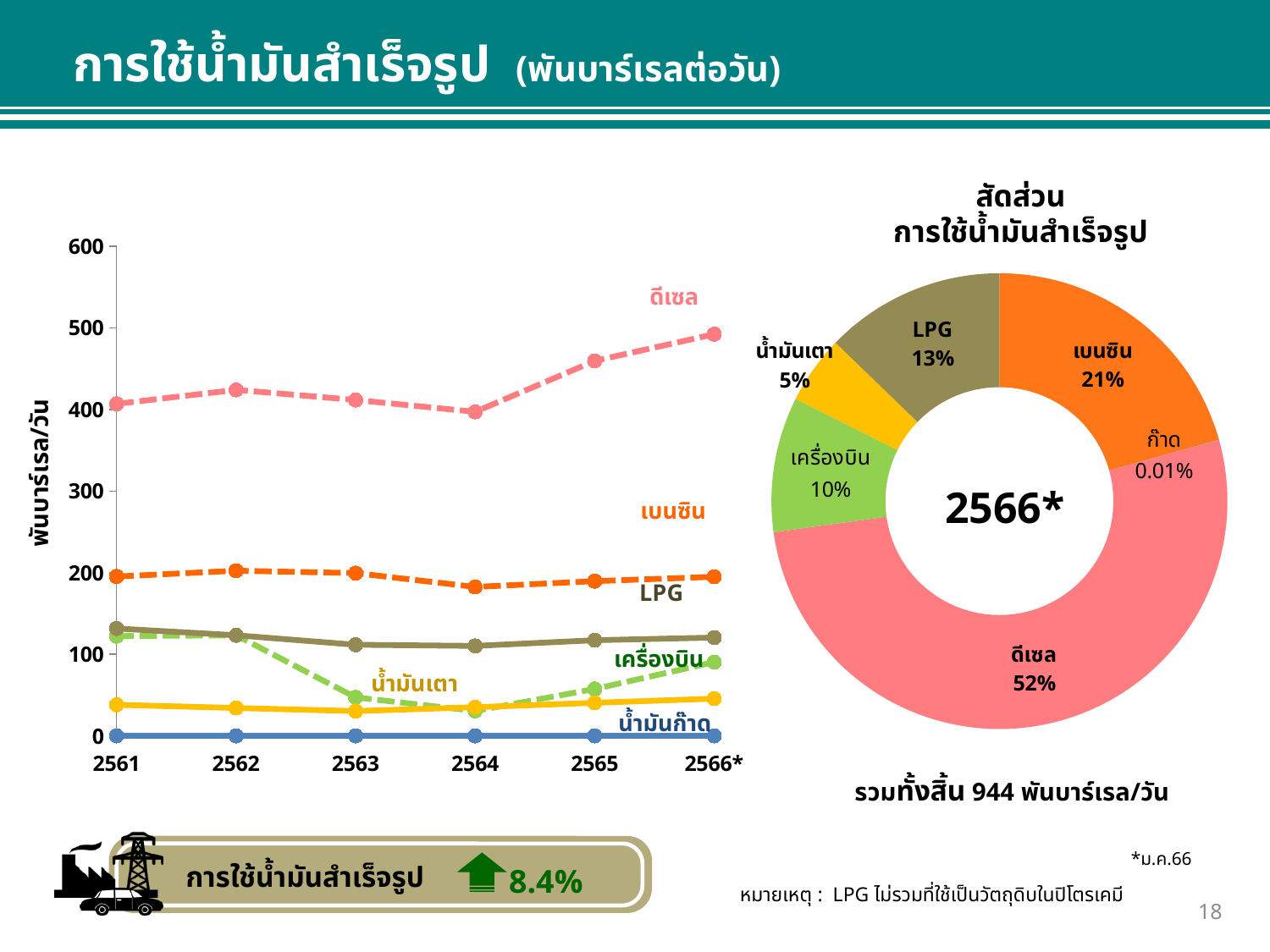
In the donut chart on the right, how many categories are shown? 6 In the donut chart on the right, what is the difference in percentage points between เบนซิน and เครื่องบิน? 11 In the donut chart titled สัดส่วนการใช้น้ำมันสำเร็จรูป, what share does ดีเซล have? 52% In the donut chart on the right, which category has the largest share? ดีเซล What kind of chart is shown on the left side of the slide? line chart In the donut chart on the right, what percentage is shown for LPG? 13% In the donut chart on the right, what percentage is shown for ก๊าด? 0.01% In the donut chart on the right, which category has the smallest share? ก๊าด In the line chart on the left, is the value for ดีเซล in 2566* greater or less than 400? greater In the line chart on the left, which series has the highest values across all years? ดีเซล In the line chart on the left, how many years are shown on the x axis? 6 In the donut chart on the right, what percentage is shown for เบนซิน? 21%